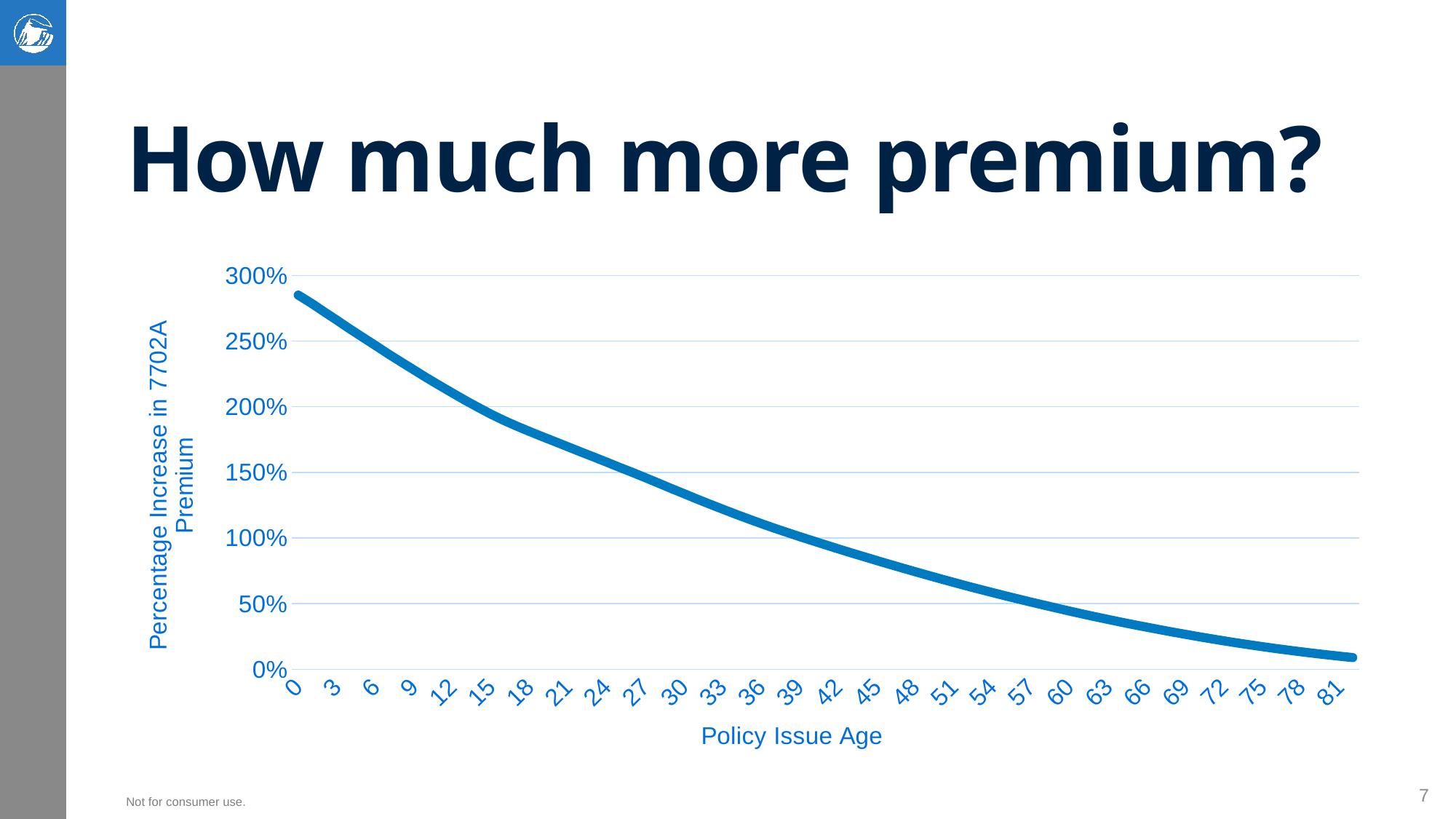
Is the value at Policy Issue Age 81 greater or less than 50%? less At which Policy Issue Age is the percentage increase in 7702A premium highest? 0 What is the title of the x axis? Policy Issue Age What is the highest tick value shown on the y axis? 300% Is the value at Policy Issue Age 30 greater or less than 100%? greater Is the value at Policy Issue Age 0 greater or less than 250%? greater What kind of chart is shown on the slide? line chart Do the values rise or fall as Policy Issue Age increases along the x axis? fall Which has the larger percentage increase in 7702A premium: Policy Issue Age 0 or Policy Issue Age 81? Policy Issue Age 0